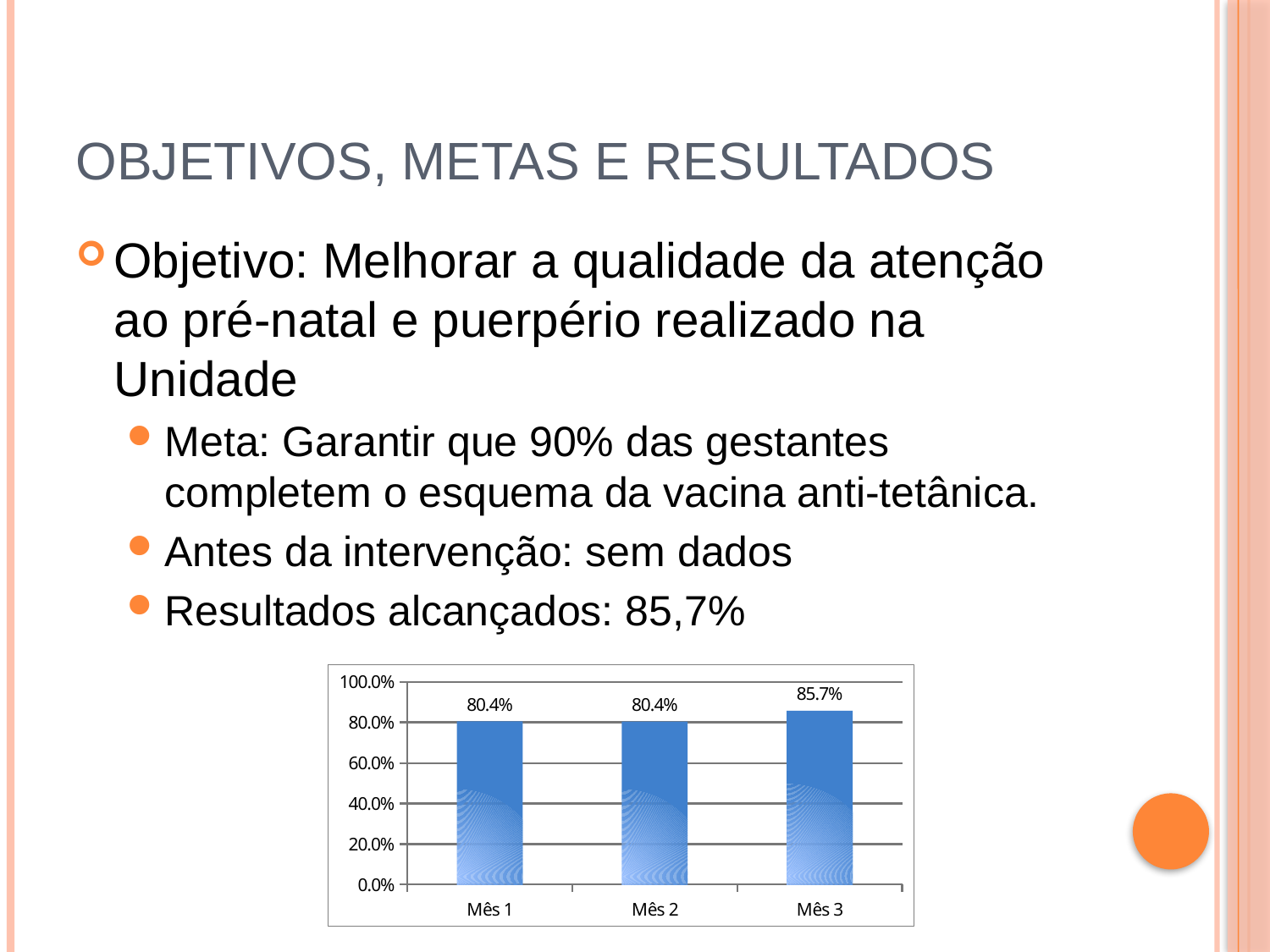
Which is larger, the value for Mês 2 or the value for Mês 3? Mês 3 How many categories are shown on the x axis? 3 What is the difference between the values for Mês 3 and Mês 1? 5.3 percentage points What is the value for Mês 1? 80.4% Which month has the highest value? Mês 3 Is the value for Mês 3 greater or less than 100.0%? less What is the value for Mês 3? 85.7% What is the value for Mês 2? 80.4% What kind of chart is shown on the slide? bar chart Is the value for Mês 1 greater or less than 60.0%? greater Do the values rise or fall from Mês 1 to Mês 3? rise What is the highest value shown on the y axis? 100.0%